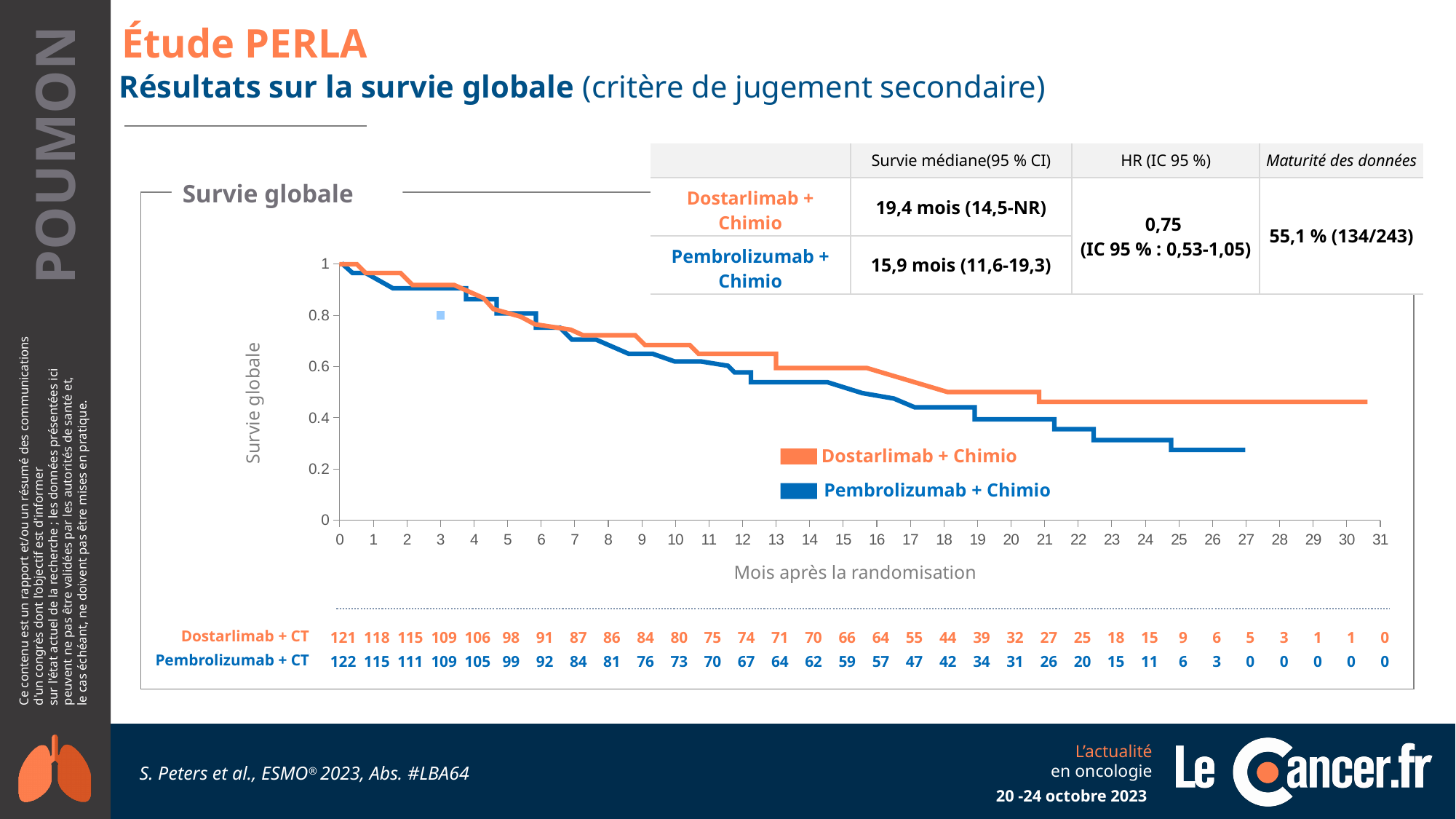
How many series does the legend of the survival chart list? 2 Is the value of the Dostarlimab + Chimio curve at month 10 greater or less than 0.6? greater Is the value of the Pembrolizumab + Chimio curve at month 24 greater or less than 0.4? less What is the x-axis title of the survival chart? Mois après la randomisation Do the survival curves rise or fall as months after randomisation increase? fall How many patients were at risk in the Dostarlimab + CT arm at month 0? 121 Is the value of the Dostarlimab + Chimio curve at month 30 greater or less than 0.4? greater What kind of chart is shown on the slide? line chart How many patients were at risk in the Pembrolizumab + CT arm at month 15? 59 What is the difference in the number of patients at risk at month 25 between Dostarlimab + CT (9) and Pembrolizumab + CT (6)? 3 Which two series are listed in the legend of the survival chart? Dostarlimab + Chimio; Pembrolizumab + Chimio At month 27, which curve is higher, Dostarlimab + Chimio or Pembrolizumab + Chimio? Dostarlimab + Chimio